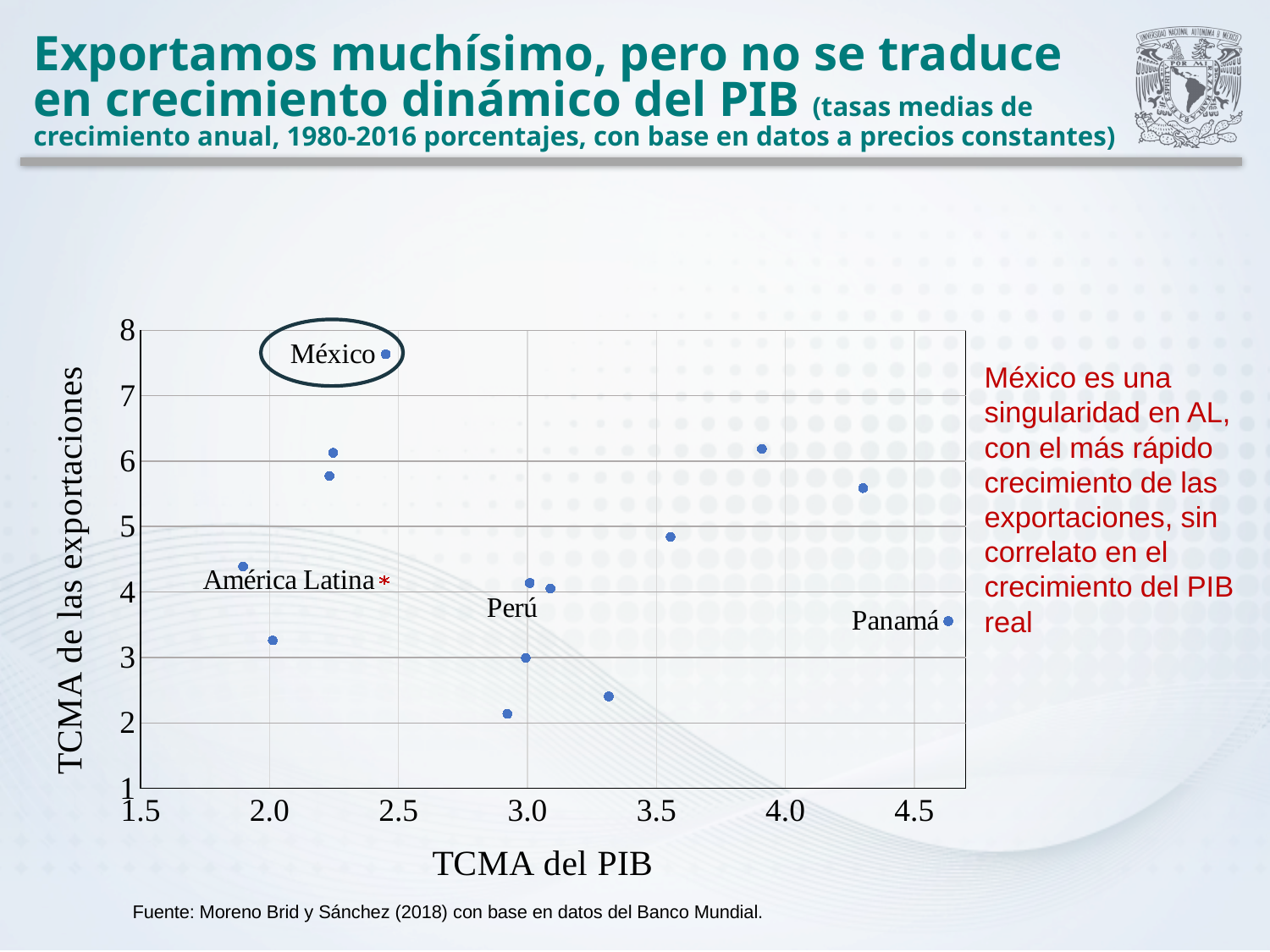
What is the title of the horizontal axis of the chart? TCMA del PIB Which labeled point on the chart is circled? México What kind of chart is shown on the slide? Scatter chart Is the TCMA del PIB value for México greater or less than 3.0? less Is the TCMA de las exportaciones value for México greater or less than 7? greater Which labeled country has the highest value on the vertical axis (TCMA de las exportaciones)? México Is the TCMA de las exportaciones value for Panamá greater or less than 4? less Which has a higher TCMA de las exportaciones, México or Panamá? México Which has a higher TCMA del PIB, Panamá or México? Panamá